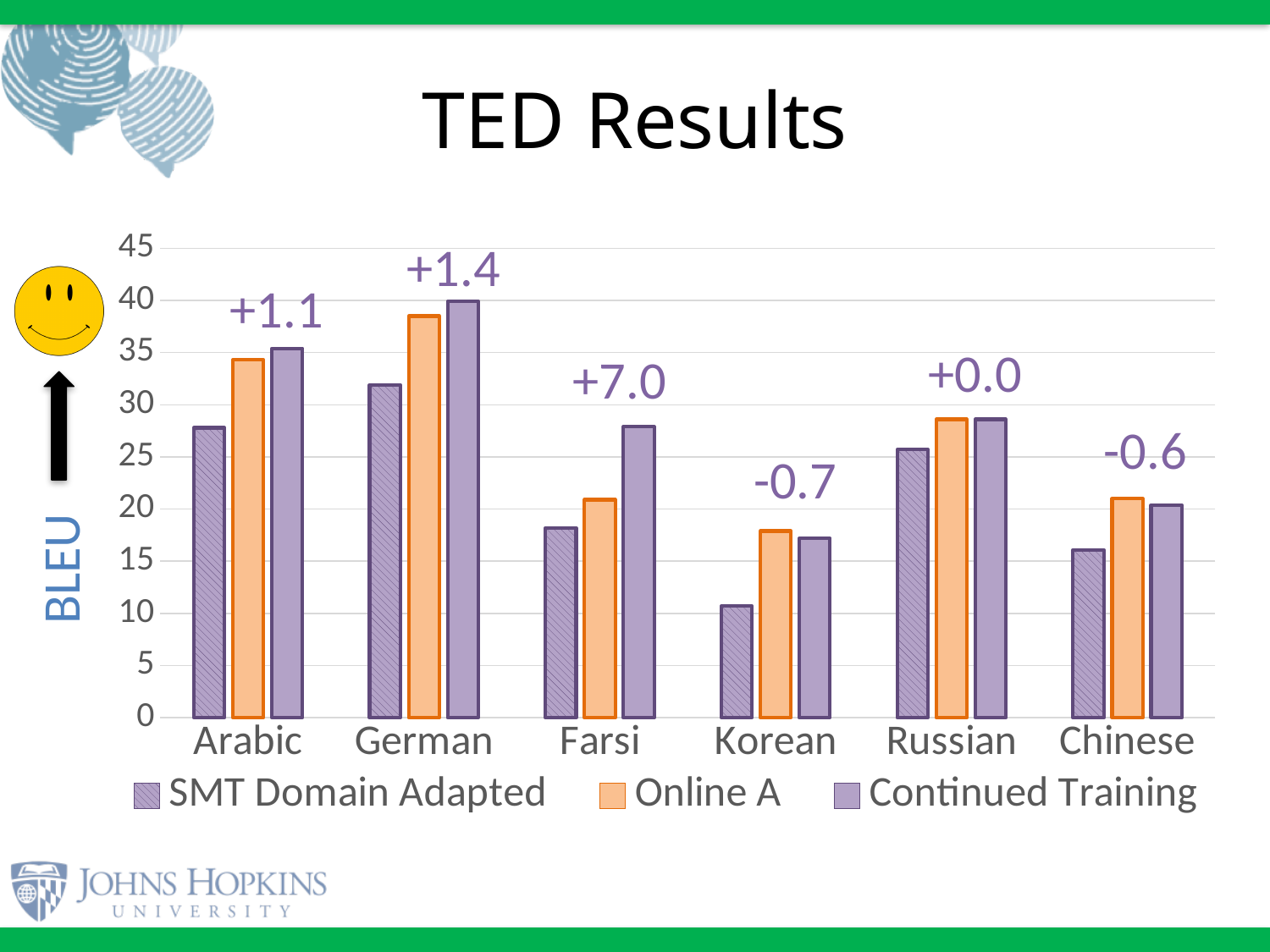
Is the SMT Domain Adapted value for Korean greater or less than 15? less Which language has the lowest SMT Domain Adapted bar? Korean Which language has the highest Continued Training bar? German What annotation value is printed above the Farsi bars? +7.0 What annotation value is printed above the Korean bars? -0.7 How many languages are shown on the x axis of the chart? 6 What kind of chart is shown on the slide? bar chart For Farsi, which is larger: the Online A bar or the Continued Training bar? Continued Training How many series does the legend list? 3 Is the Continued Training value for Farsi greater or less than 25? greater Is the Continued Training value for Arabic greater or less than 30? greater What is the label on the y axis of the chart? BLEU